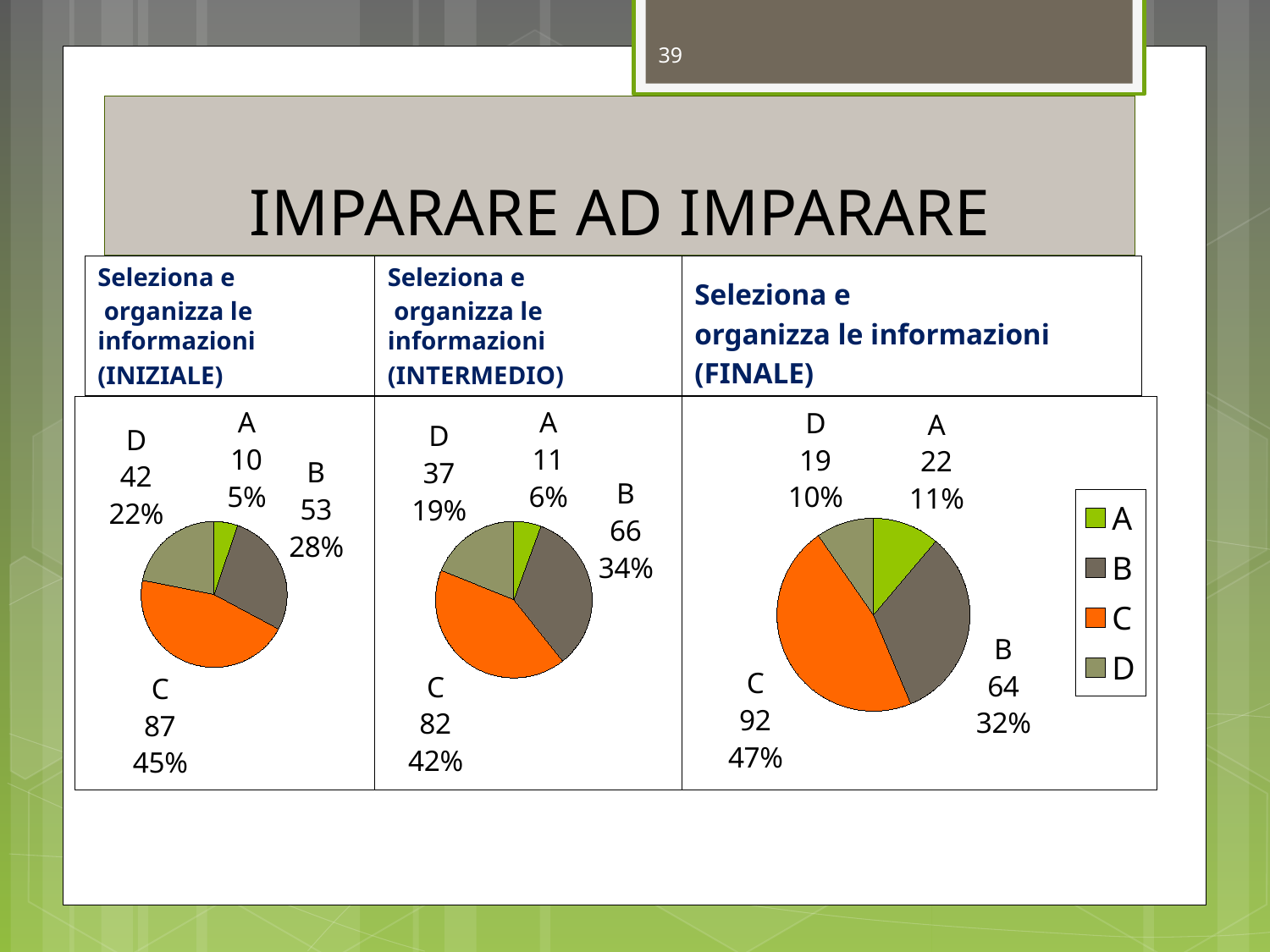
In the INIZIALE pie chart, what share of the pie does category D have? 22% In the INTERMEDIO pie chart, which category has the smallest slice? A In the FINALE pie chart, what share of the pie does category B have? 32% What kind of chart is used in the FINALE panel? Pie chart In the INIZIALE pie chart, which is larger, the value for B or the value for D? B In the FINALE pie chart, what is the value for category D? 19 In the FINALE pie chart, what is the difference between the values for C and B? 28 How many categories does the INTERMEDIO pie chart show? 4 In the FINALE chart legend, which colour represents category C? Orange In the FINALE pie chart, which category has the largest slice? C In the INIZIALE pie chart, what is the value for category C? 87 In the INTERMEDIO pie chart, what is the value for category B? 66